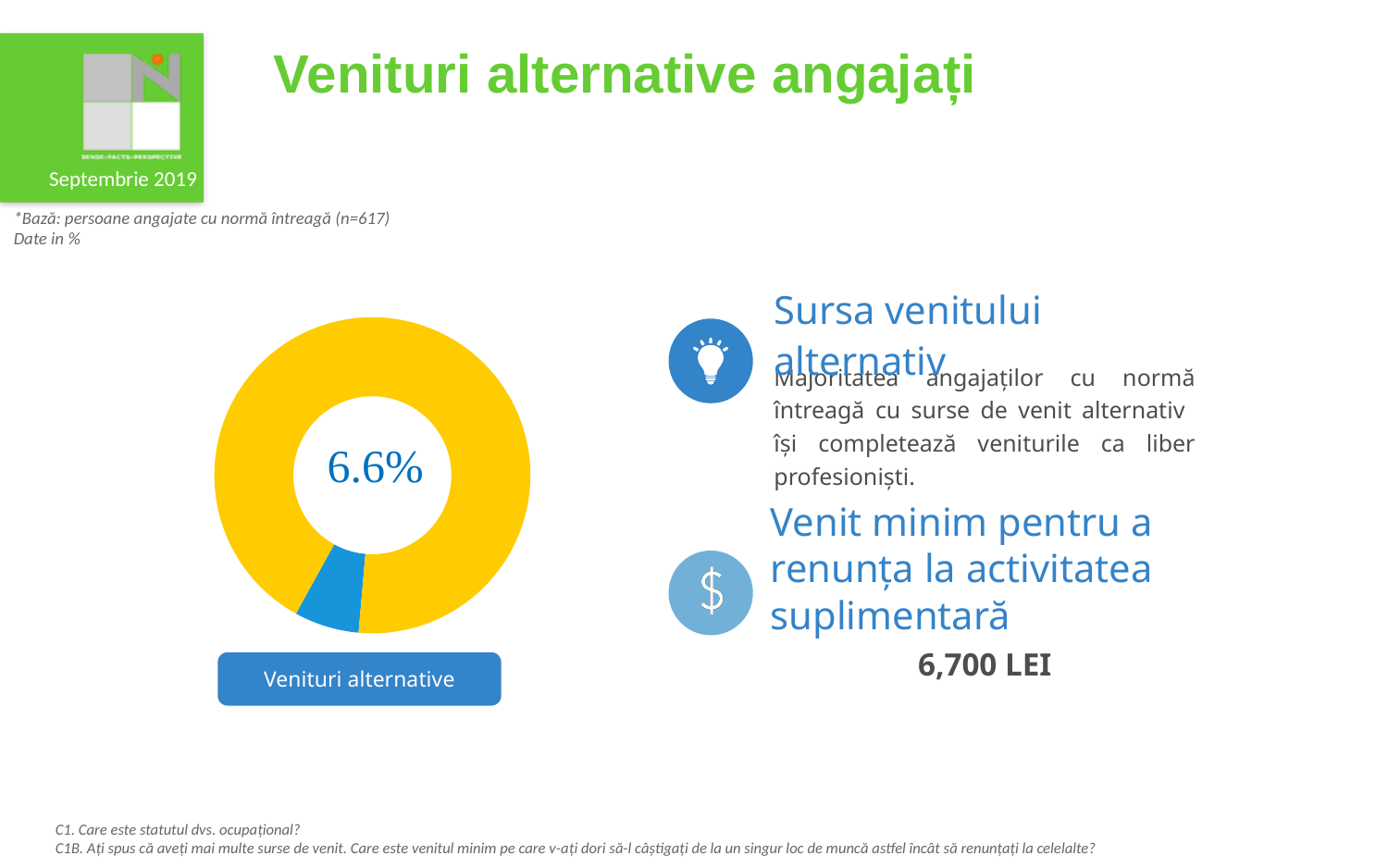
How many slices does the donut chart have? 2 What is the sample size (n) stated in the base note above the chart? 617 What label appears in the box below the donut chart? Venituri alternative What share of full-time employees have alternative incomes (Venituri alternative) according to the chart? 6.6% What colour is the slice representing the 6.6% value in the donut chart? Blue What percentage is printed in the centre of the donut chart? 6.6% What is the share of the yellow slice of the donut chart, given the blue slice is 6.6%? 93.4% Is the blue slice of the donut chart greater or less than 10% of the whole? less What kind of chart is shown on the slide? Donut (pie) chart Which slice of the donut chart is larger, the blue one or the yellow one? The yellow one